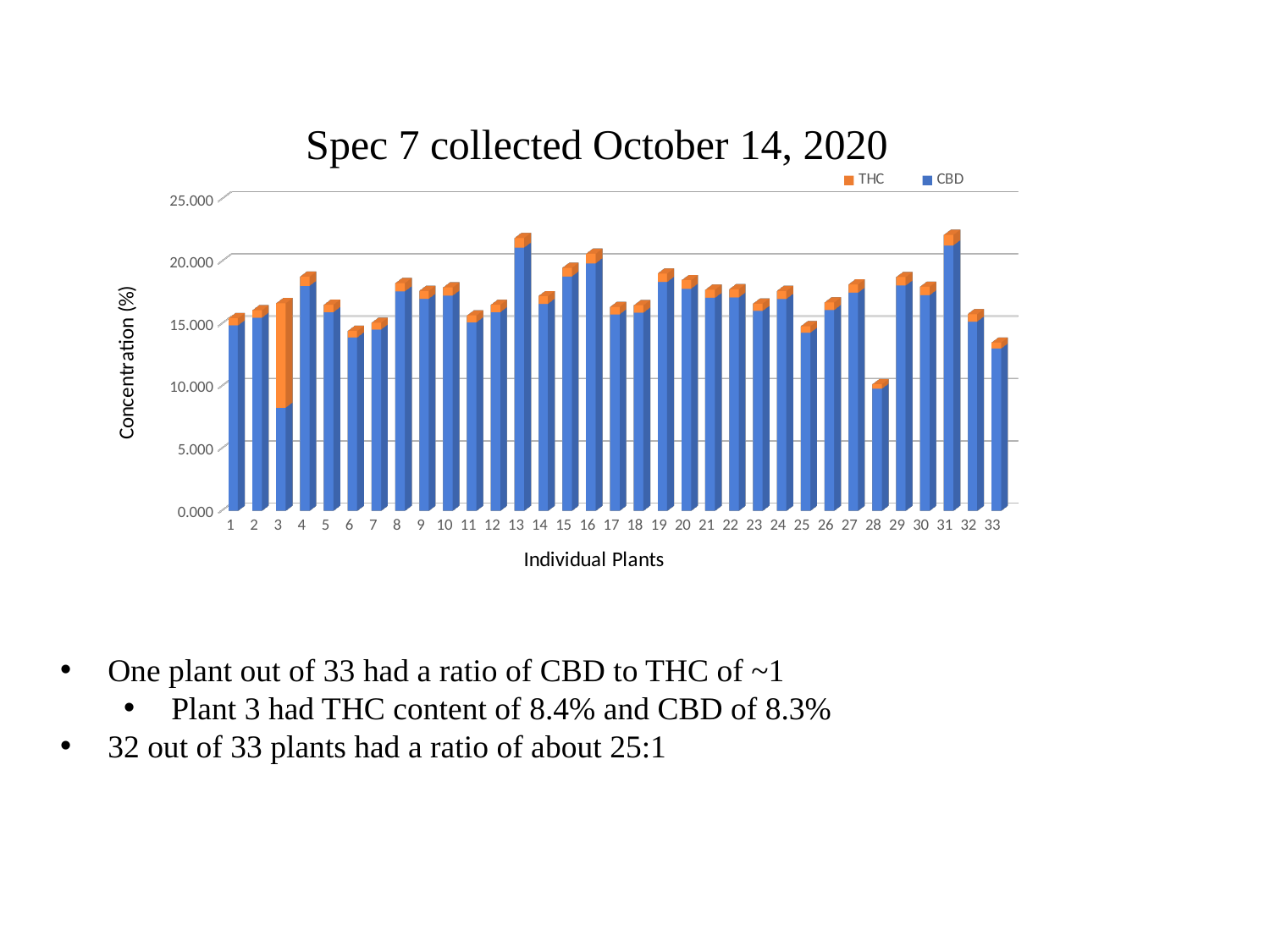
How many series does the legend list? 2 What kind of chart is shown on the slide? Stacked bar chart Is the total value for plant 28 greater or less than 15.000? less Is the CBD value for plant 3 greater or less than 10.000? less Is the total value for plant 33 greater or less than 15.000? less Which plant has the lowest total bar? 28 Which colour represents CBD in the chart? Blue What is the title of the chart? Spec 7 collected October 14, 2020 How many individual plants are plotted on the x axis? 33 Which has the larger total bar, plant 13 or plant 14? Plant 13 Which plant has the largest THC segment? 3